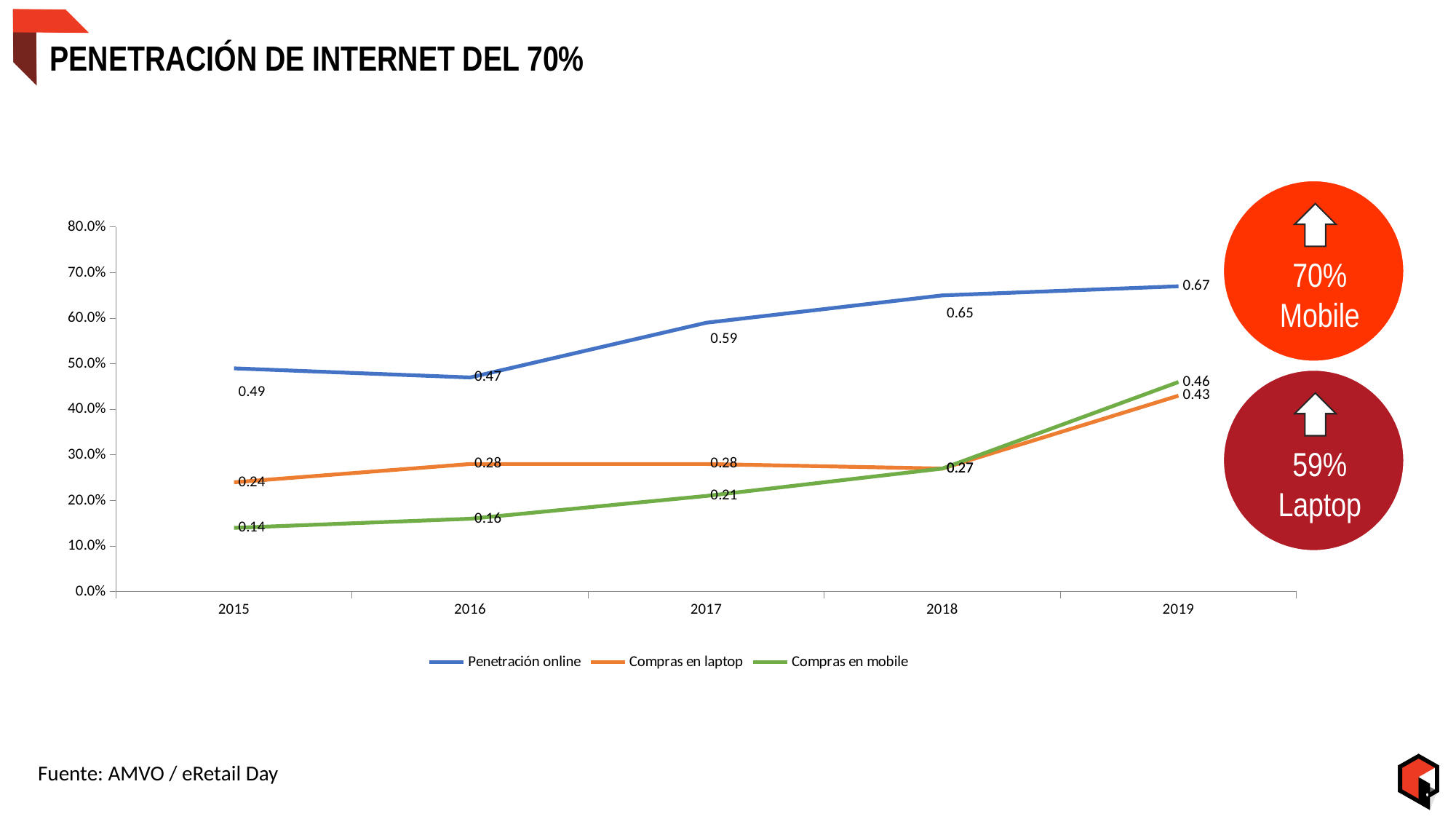
Is the value for Penetración online in 2016 greater or less than 50.0%? less What is the value of Compras en laptop in 2015? 0.24 What is the value of Penetración online in 2019? 0.67 How many series does the legend list? 3 What is the difference between Penetración online in 2019 and in 2015? 0.18 What kind of chart is shown on the slide? line chart What is the value of Compras en mobile in 2017? 0.21 What is the difference between Compras en laptop in 2019 and in 2017? 0.15 In which year is Penetración online highest? 2019 In which year is Compras en mobile lowest? 2015 In 2019, which is larger: Compras en laptop or Compras en mobile? Compras en mobile How many years are shown on the x axis? 5